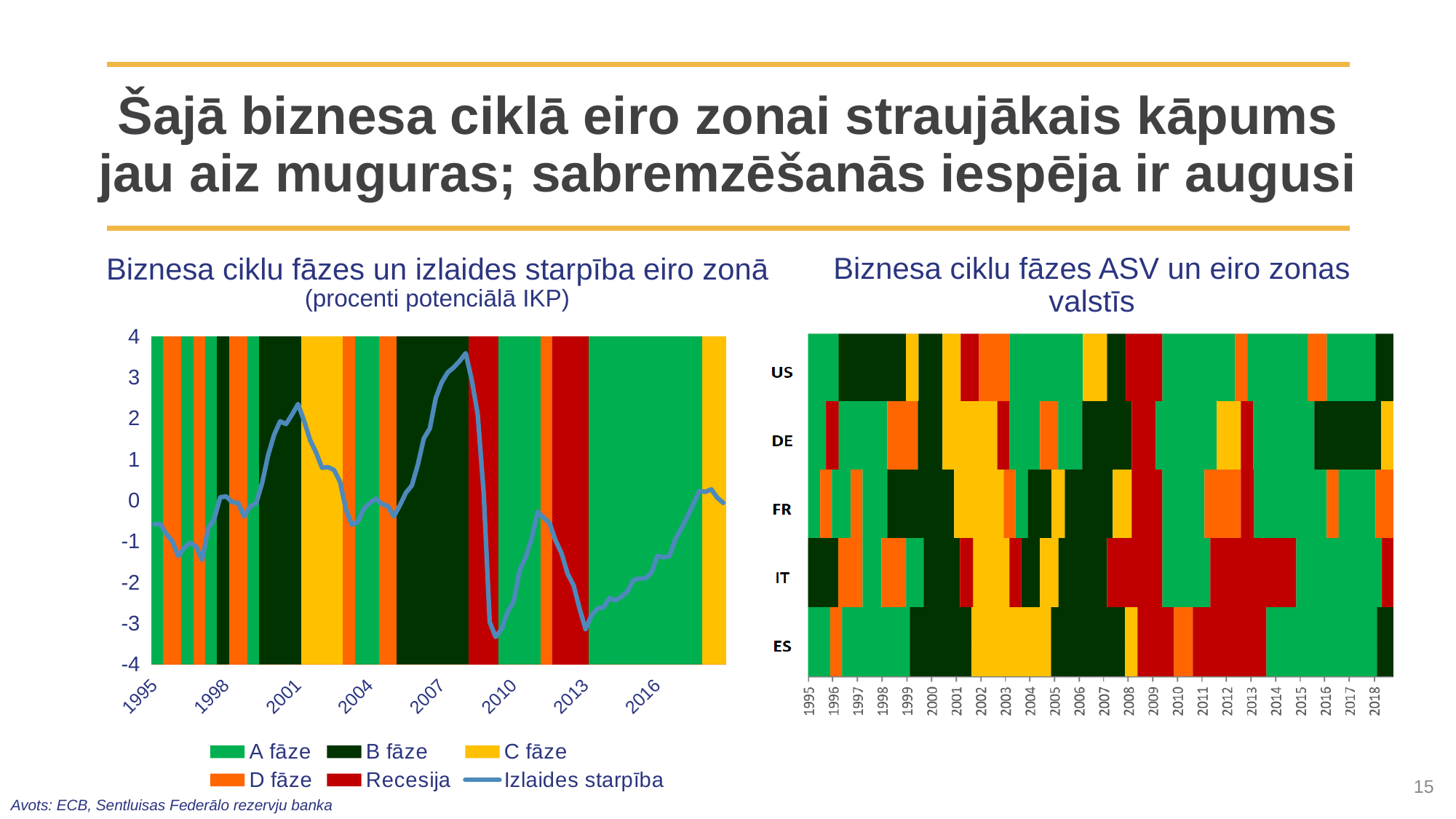
On the left chart, what is the title of the chart? Biznesa ciklu fāzes un izlaides starpība eiro zonā On the left chart, how many entries does the legend list? 6 On the right chart, what is the last year shown on the horizontal axis? 2018 On the right chart, how many countries are shown as rows? 5 On the left chart, which legend entry is drawn as a blue line? Izlaides starpība On the left chart, is the value of Izlaides starpība at its 2001 peak greater or less than 2? greater On the left chart, is the peak value of Izlaides starpība around 2008 greater or less than 3? greater On the left chart, is the lowest value of Izlaides starpība around 2009 greater or less than -2? less On the right chart, what is the first year shown on the horizontal axis? 1995 On the left chart, does Izlaides starpība rise or fall between 2013 and 2017? rise On the right chart, which country is listed in the top row? US On the left chart, what are the minimum and maximum values shown on the vertical axis? -4 and 4